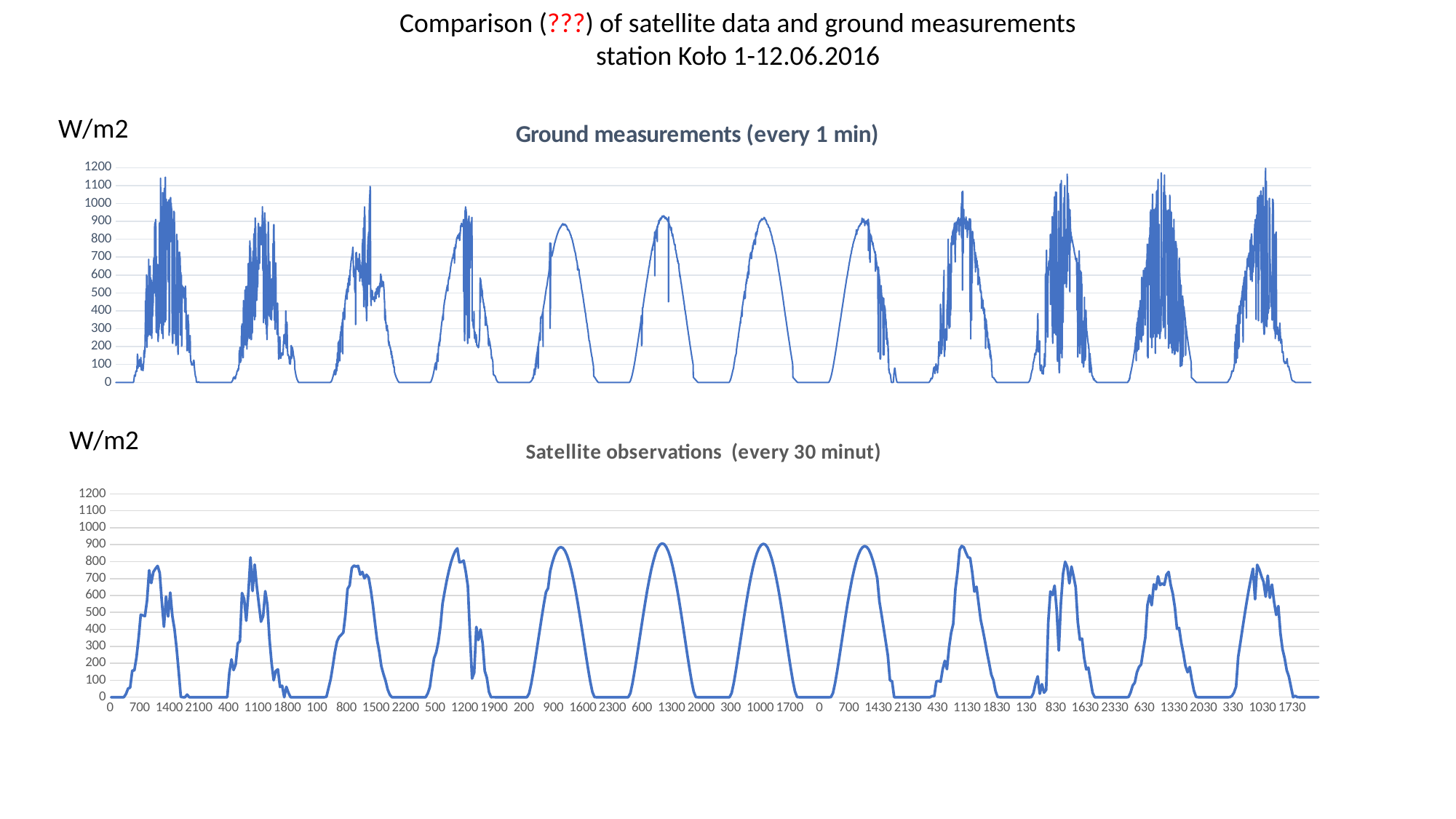
What is the maximum value shown on the vertical axis of the 'Ground measurements (every 1 min)' chart? 1200 What is the lowest value the line drops to in the 'Ground measurements (every 1 min)' chart? 0 How many daily peaks are shown in the 'Satellite observations (every 30 minut)' chart? 12 Which chart reaches a higher peak value, 'Ground measurements (every 1 min)' or 'Satellite observations (every 30 minut)'? Ground measurements (every 1 min) What kind of chart is the 'Satellite observations (every 30 minut)' chart? line chart What unit is given for the vertical axis of both charts? W/m2 In the 'Ground measurements (every 1 min)' chart, is the highest value reached greater or less than 1000? greater In the 'Satellite observations (every 30 minut)' chart, is the highest value reached greater or less than 1000? less What kind of chart is the 'Ground measurements (every 1 min)' chart? line chart In the 'Satellite observations (every 30 minut)' chart, is the highest value reached greater or less than 800? greater